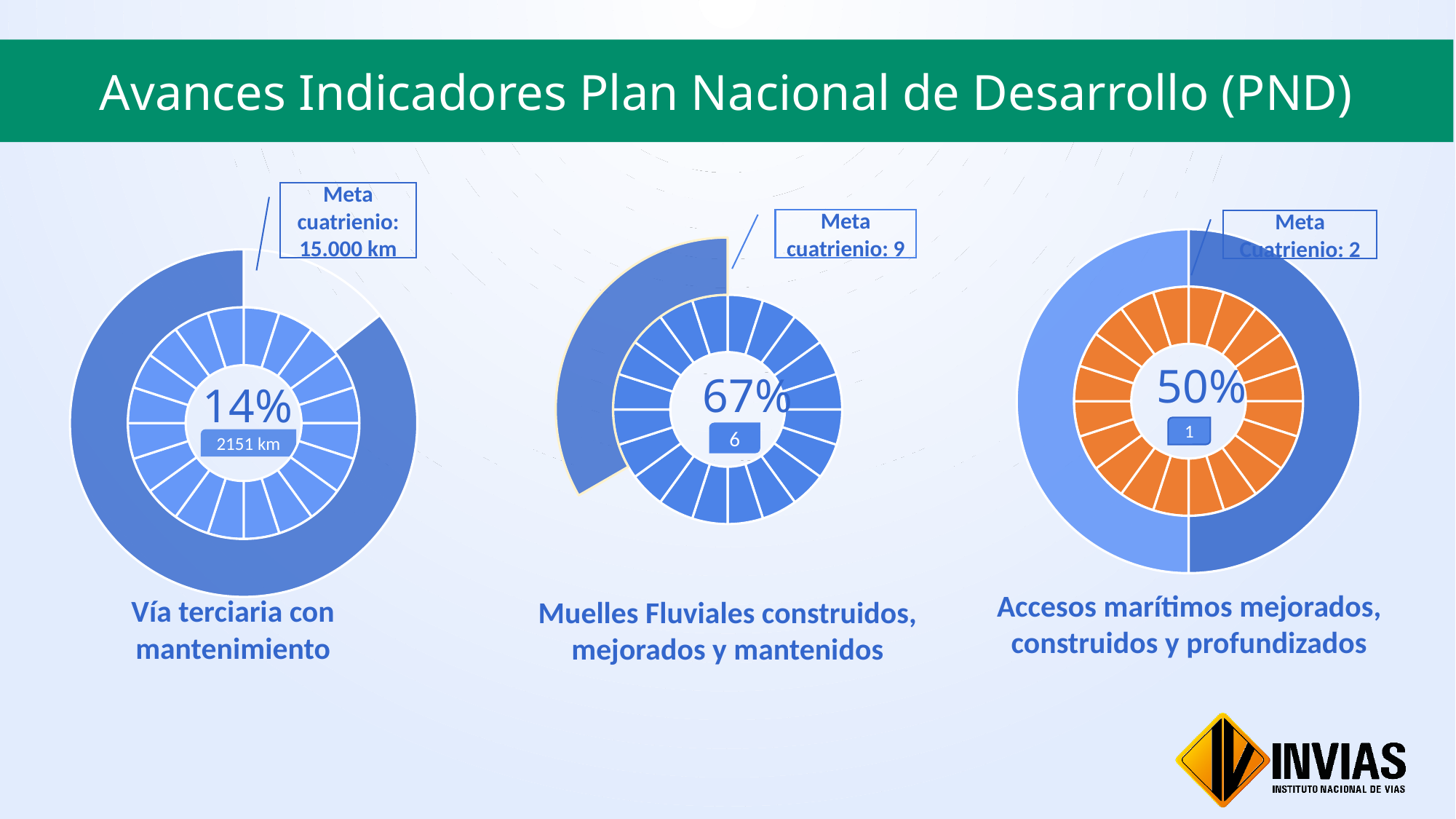
On the 'Accesos marítimos mejorados, construidos y profundizados' chart, what is the 'Meta Cuatrienio' target? 2 On the 'Accesos marítimos mejorados, construidos y profundizados' chart, what value is shown below the percentage? 1 On the 'Vía terciaria con mantenimiento' chart, what is the 'Meta cuatrienio' target? 15.000 km On the 'Vía terciaria con mantenimiento' chart, what percentage of progress is shown in the centre? 14% Which is larger: the progress percentage for 'Accesos marítimos mejorados, construidos y profundizados' or for 'Vía terciaria con mantenimiento'? Accesos marítimos mejorados, construidos y profundizados On the 'Muelles Fluviales construidos, mejorados y mantenidos' chart, what percentage is shown in the centre? 67% On the 'Muelles Fluviales construidos, mejorados y mantenidos' chart, how many more muelles are needed to reach the 'Meta cuatrienio' target of 9 from the achieved 6? 3 On the 'Muelles Fluviales construidos, mejorados y mantenidos' chart, what is the 'Meta cuatrienio' target? 9 On the 'Vía terciaria con mantenimiento' chart, how many kilometres have been achieved? 2151 km What is the title of the slide containing the three progress charts? Avances Indicadores Plan Nacional de Desarrollo (PND) Which of the three indicators on the slide shows the lowest percentage of progress? Vía terciaria con mantenimiento Which of the three indicators on the slide shows the highest percentage of progress? Muelles Fluviales construidos, mejorados y mantenidos